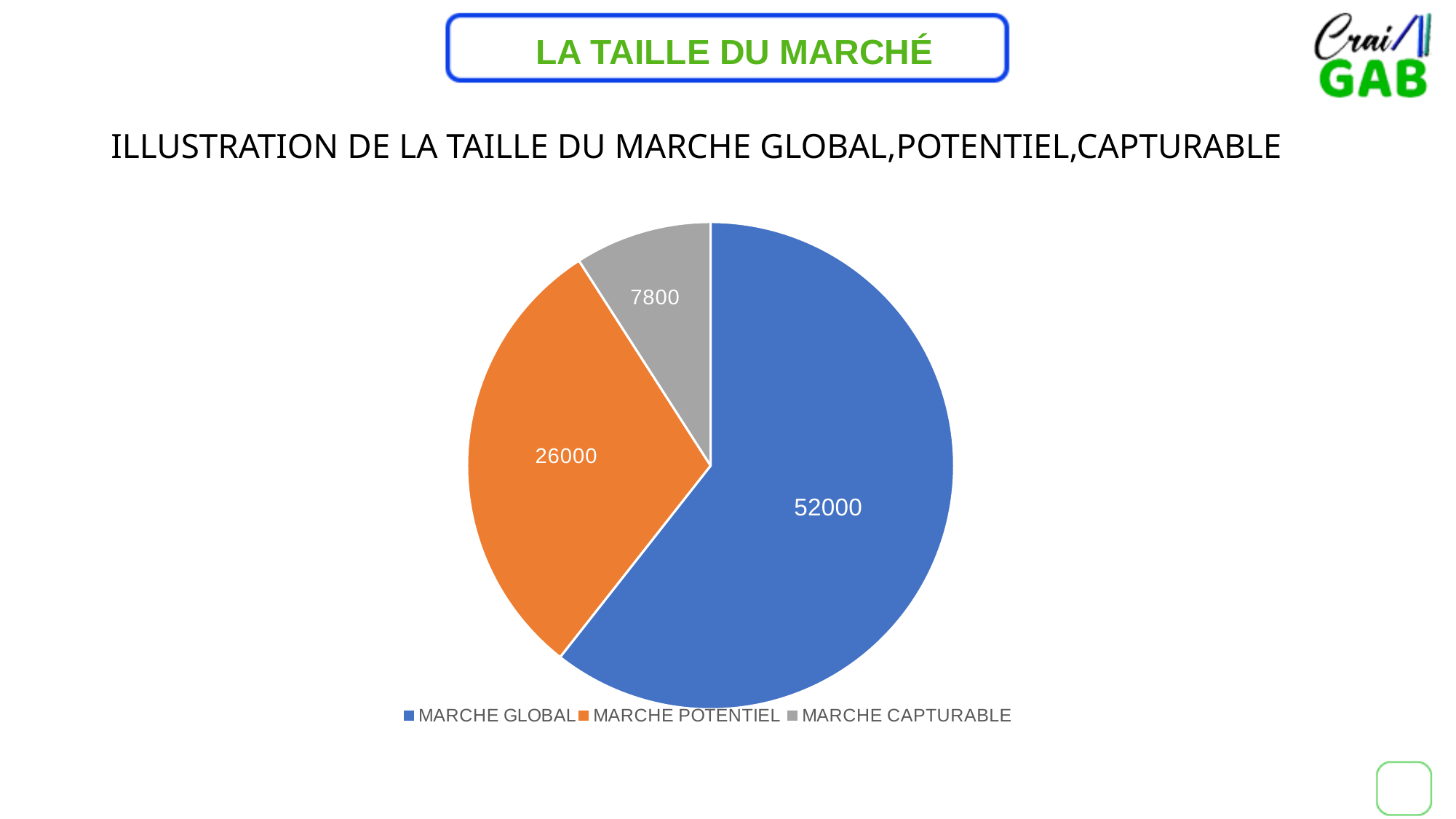
What kind of chart is shown on the slide? Pie chart Which category has the largest slice of the pie? MARCHE GLOBAL What value is shown for MARCHE CAPTURABLE? 7800 Which is larger, MARCHE POTENTIEL or MARCHE CAPTURABLE? MARCHE POTENTIEL Which category has the smallest slice of the pie? MARCHE CAPTURABLE What is the difference between the values for MARCHE GLOBAL and MARCHE POTENTIEL? 26000 What colour is the MARCHE POTENTIEL slice? Orange What is the total of all three slices in the pie chart? 85800 What is the difference between the values for MARCHE POTENTIEL and MARCHE CAPTURABLE? 18200 How many slices does the pie chart have? 3 What value is shown for MARCHE GLOBAL? 52000 What value is shown for MARCHE POTENTIEL? 26000